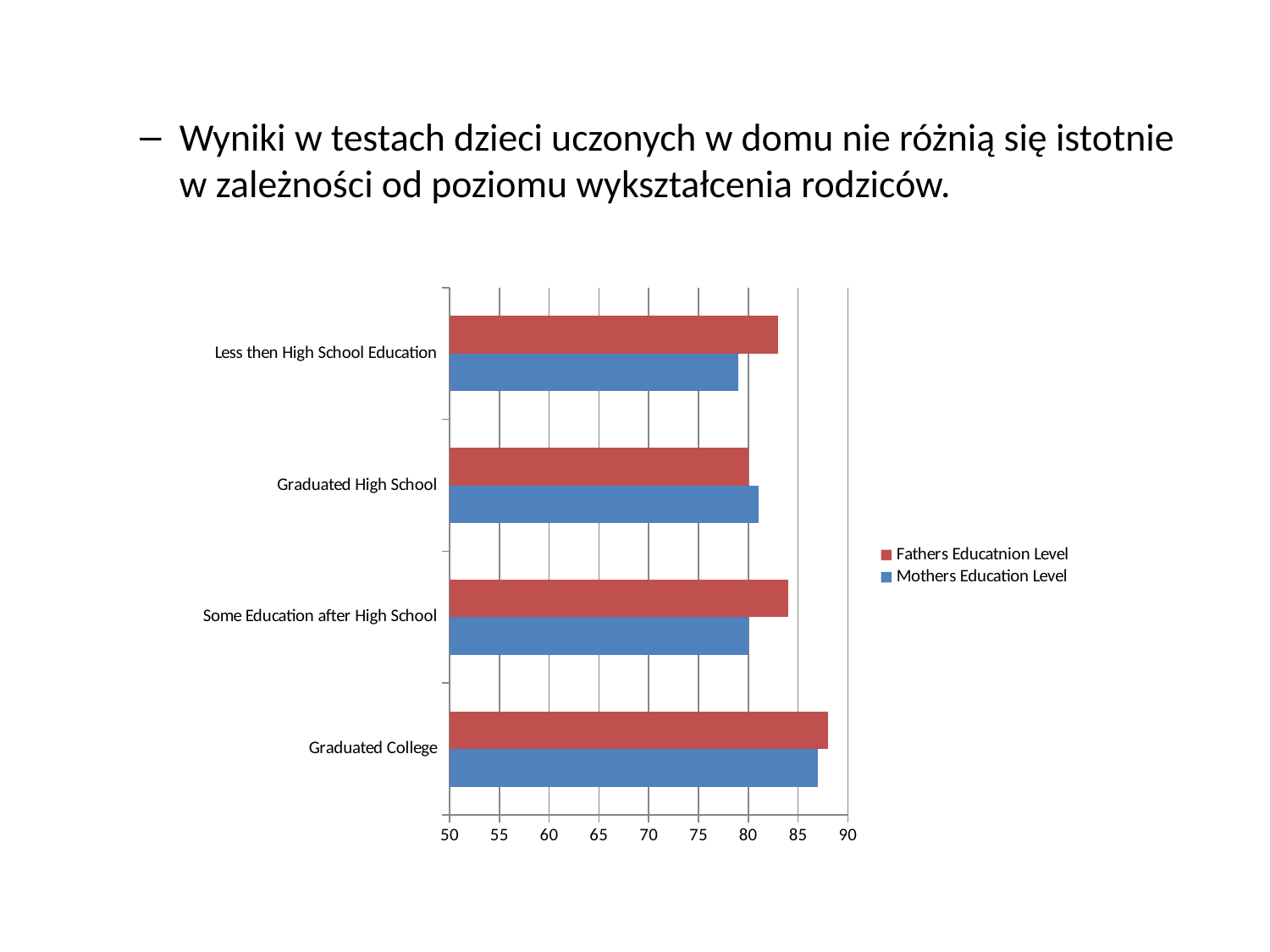
How many education-level categories are shown on the chart? 4 For Some Education after High School, which series has the larger value: Fathers Educatnion Level or Mothers Education Level? Fathers Educatnion Level For Less then High School Education, which series has the larger value: Fathers Educatnion Level or Mothers Education Level? Fathers Educatnion Level Is the Fathers Educatnion Level value for Graduated College greater or less than 85? greater Which category has the highest value for Fathers Educatnion Level? Graduated College What colour are the bars for the Mothers Education Level series? blue Is the Mothers Education Level value for Graduated College greater or less than 85? greater How many series does the chart's legend list? 2 Is the Fathers Educatnion Level value for Less then High School Education greater or less than 80? greater What kind of chart is shown on the slide? bar chart Which category has the highest value for Mothers Education Level? Graduated College Which category has the lowest value for Fathers Educatnion Level? Graduated High School